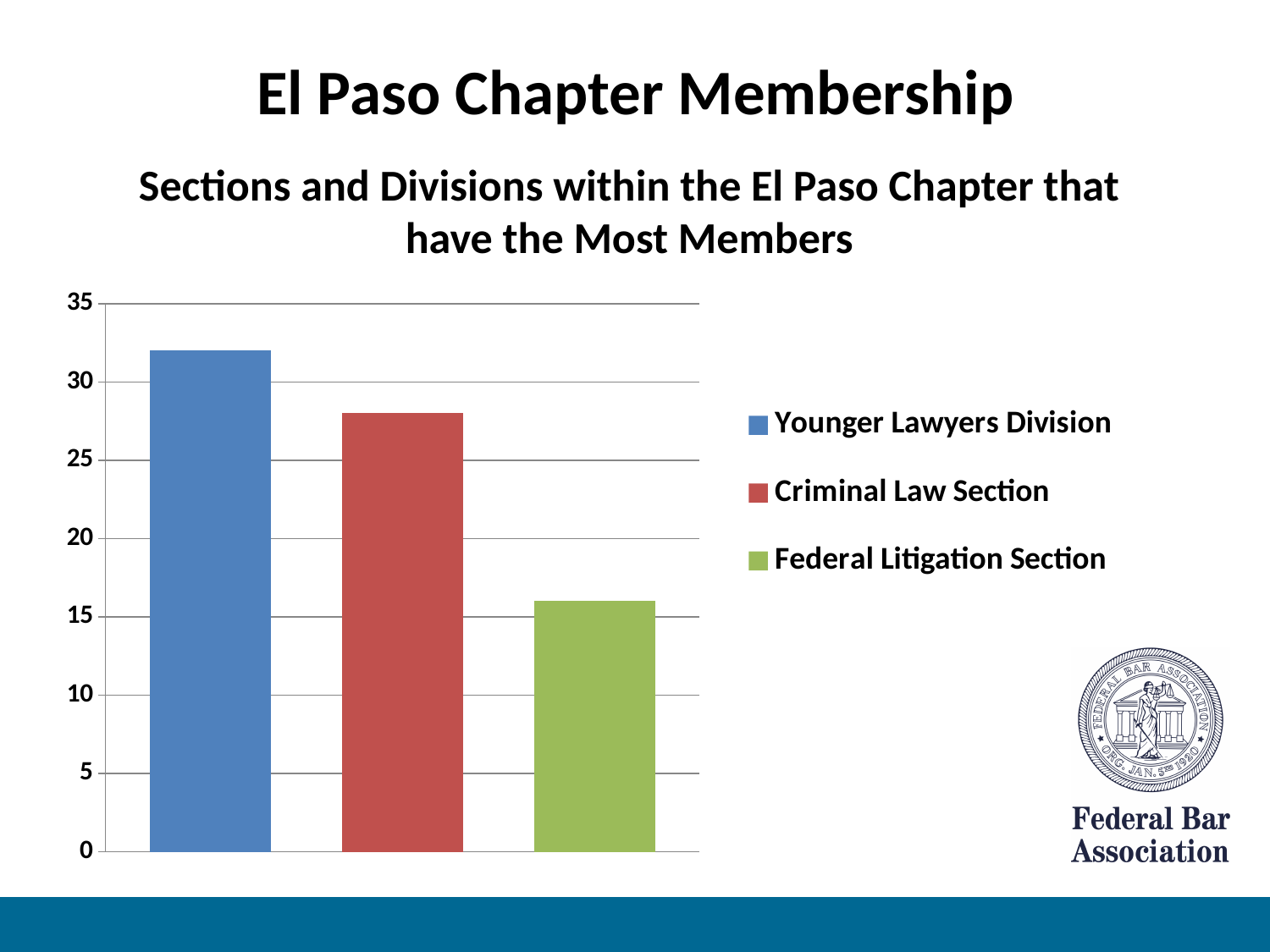
What kind of chart is shown on the slide? bar chart Which has more members, the Criminal Law Section or the Federal Litigation Section? Criminal Law Section What colour is the bar for the Criminal Law Section? red Which section or division has the fewest members according to the chart? Federal Litigation Section Is the value for the Criminal Law Section greater or less than 30? less Is the value for the Younger Lawyers Division greater or less than 30? greater Which has more members, the Younger Lawyers Division or the Criminal Law Section? Younger Lawyers Division How many entries does the chart's legend list? 3 How many bars are plotted in the chart? 3 Which section or division has the most members according to the chart? Younger Lawyers Division Is the value for the Federal Litigation Section greater or less than 20? less Do the bar values rise or fall from left to right across the chart? fall